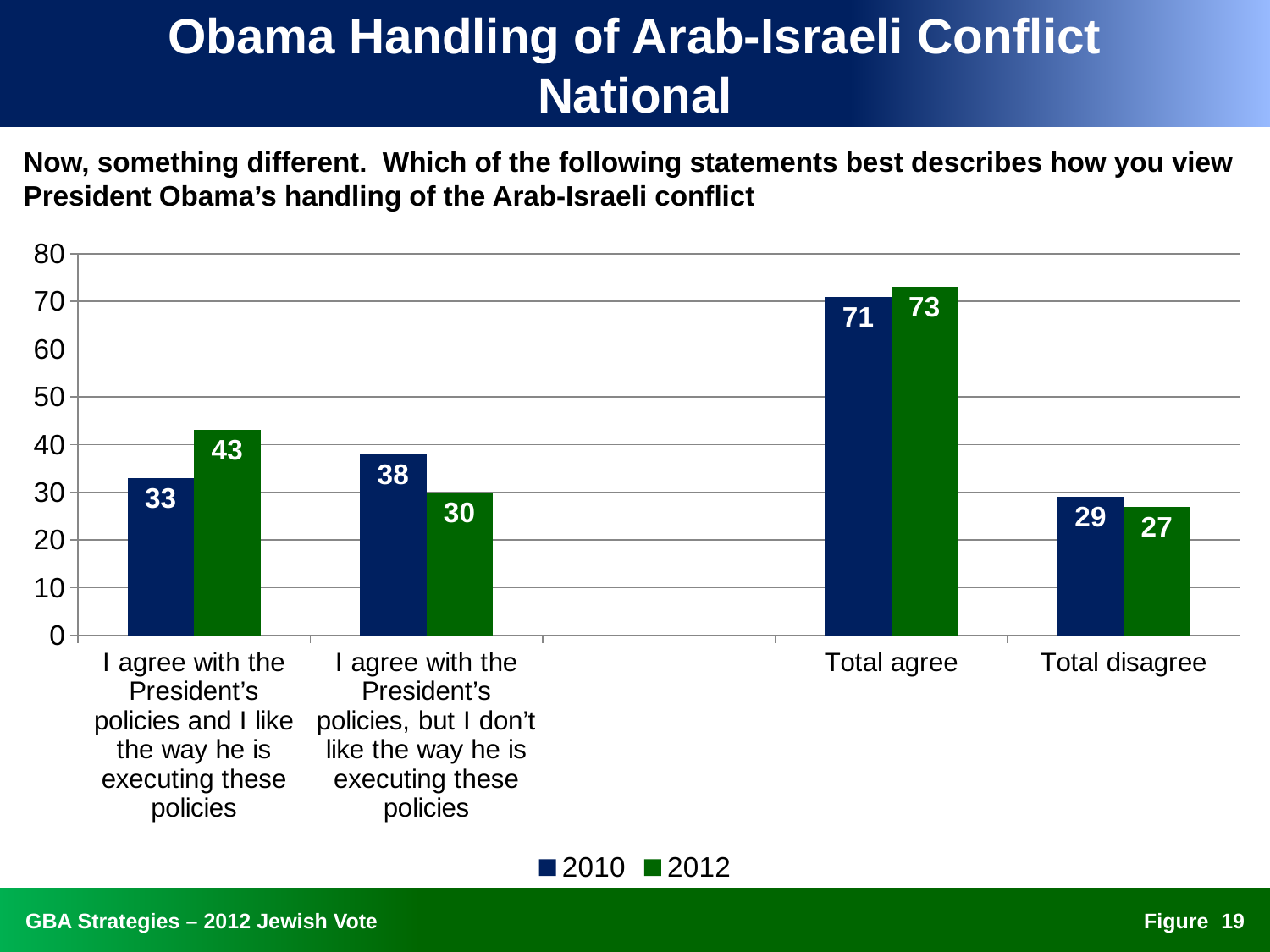
What is the 2012 value for "Total disagree"? 27 For "Total disagree", which year has the larger value, 2010 or 2012? 2010 What is the difference between the 2012 and 2010 values for "I agree with the President's policies and I like the way he is executing these policies"? 10 What is the 2012 value for "Total agree"? 73 Which category has the lowest 2012 value? Total disagree What kind of chart is shown on the slide? bar chart How many series does the legend list? 2 Is the 2010 value for "Total agree" greater or less than 60? greater How many categories are shown on the x axis? 4 Which series is shown in green in the legend? 2012 Which category has the highest 2010 value? Total agree What is the 2010 value for "I agree with the President's policies, but I don't like the way he is executing these policies"? 38